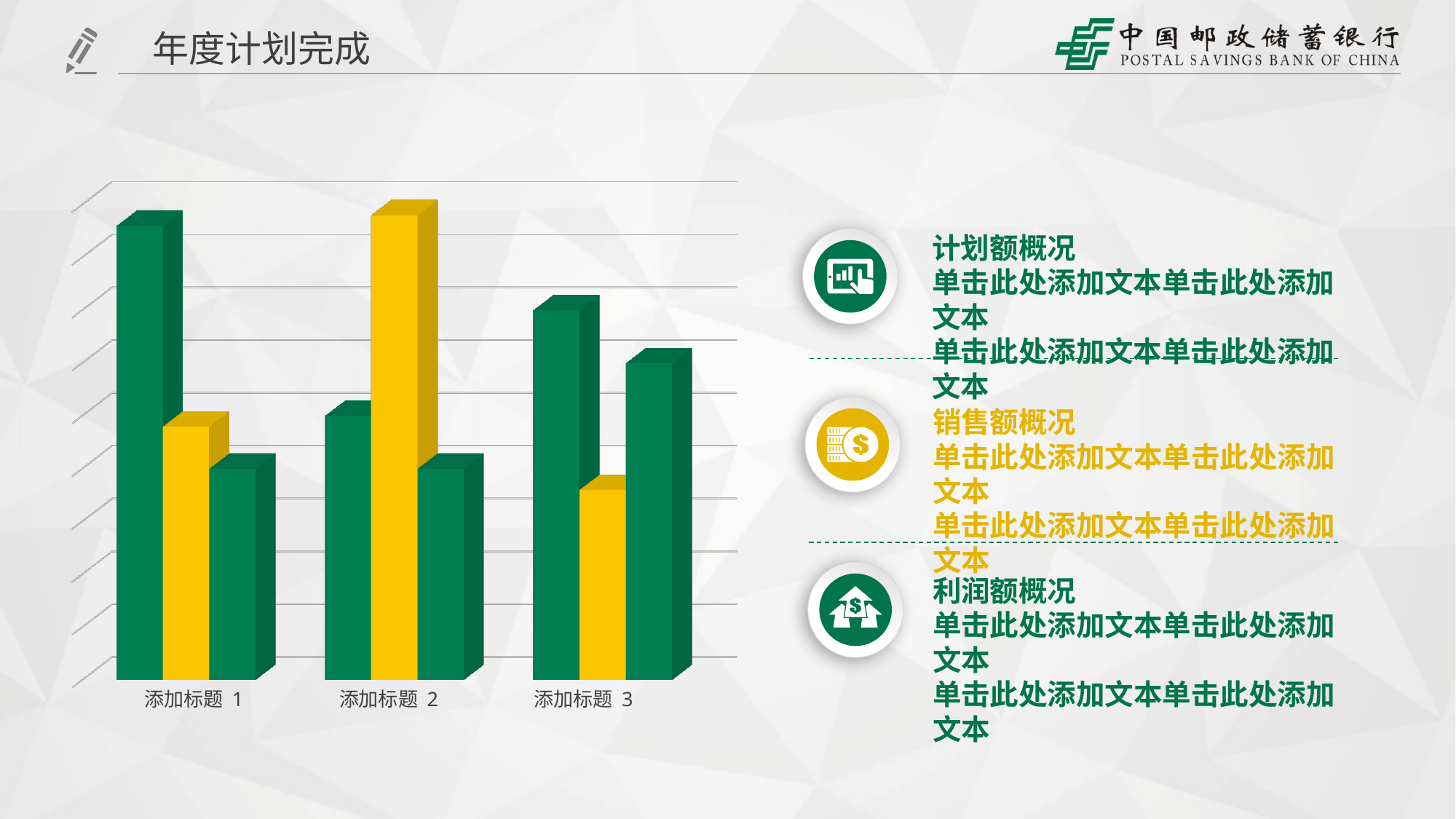
In the category 添加标题 2, is the yellow bar taller or shorter than the dark green bar? taller How many bars are plotted for each category in the chart? 3 Which category has the shortest yellow bar? 添加标题 3 How many categories are shown on the x axis of the chart? 3 Which category has the tallest yellow bar? 添加标题 2 Does the chart display a legend? No What kind of chart is shown on the slide? bar chart In the category 添加标题 1, which bar is the tallest? the dark green (first) bar Which category has the tallest green (third) bar? 添加标题 3 In the category 添加标题 3, which bar is the shortest? the yellow bar In the category 添加标题 1, is the yellow bar taller or shorter than the green (third) bar? taller